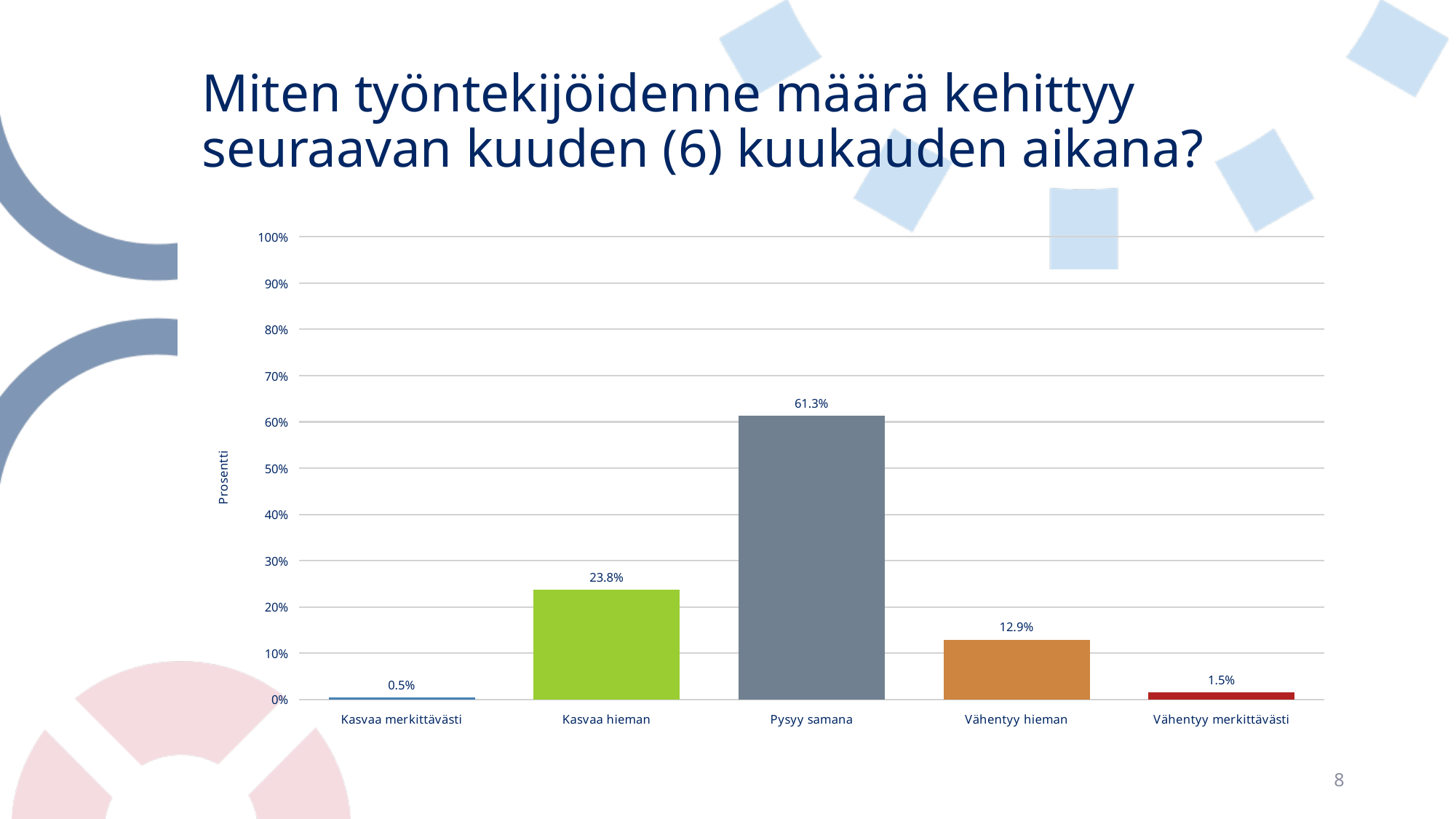
Is the value for "Pysyy samana" greater or less than 50%? greater What kind of chart is shown on the slide? bar chart What is the label of the vertical axis? Prosentti Which is larger, the value for "Vähentyy hieman" or the value for "Kasvaa hieman"? Kasvaa hieman How many categories are shown on the x axis? 5 What is the value for "Vähentyy merkittävästi"? 1.5% What colour is the bar for "Kasvaa hieman"? green What is the value for "Kasvaa hieman"? 23.8% What is the difference between the values for "Kasvaa hieman" and "Vähentyy hieman"? 10.9% Which category has the lowest value? Kasvaa merkittävästi Which category has the highest value? Pysyy samana What is the value for "Pysyy samana"? 61.3%